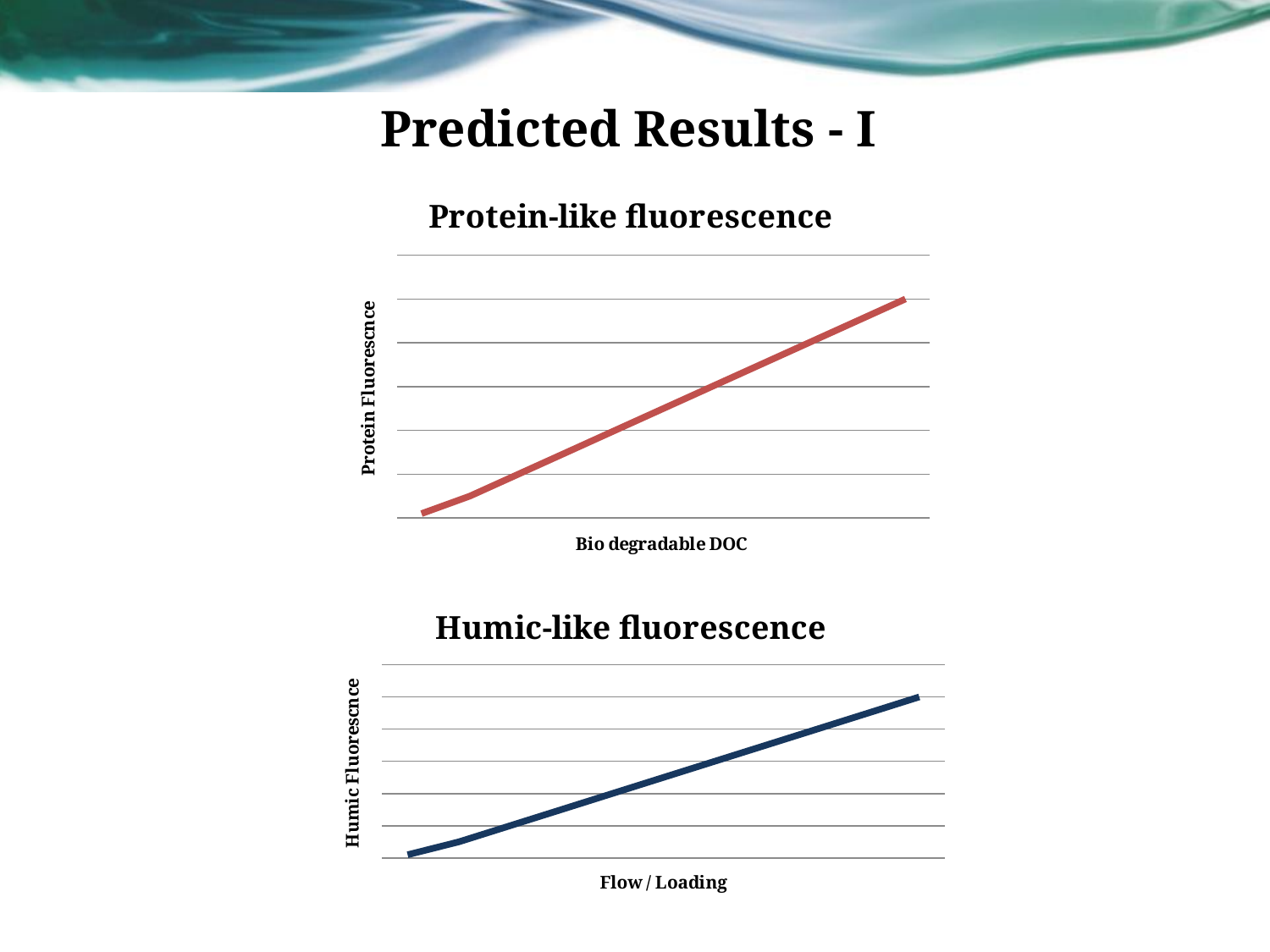
In the 'Protein-like fluorescence' chart, does protein fluorescence rise or fall as biodegradable DOC increases along the x axis? rise What colour is the line in the 'Humic-like fluorescence' chart? dark blue What kind of chart is the 'Humic-like fluorescence' chart? line chart What is the x-axis label of the 'Protein-like fluorescence' chart? Bio degradable DOC In the 'Humic-like fluorescence' chart, does humic fluorescence rise or fall as flow / loading increases along the x axis? rise What kind of chart is the 'Protein-like fluorescence' chart? line chart